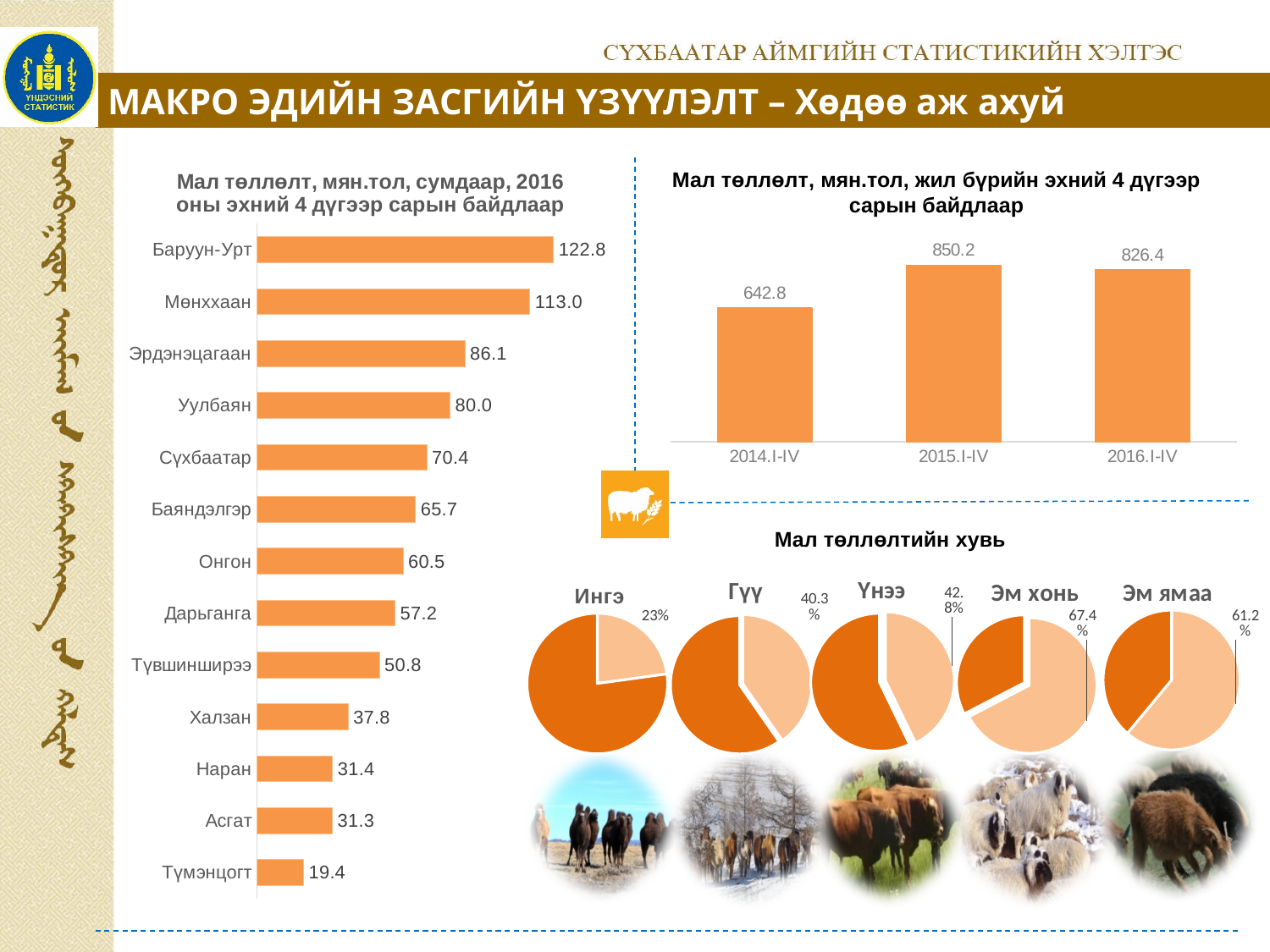
In the left chart (Мал төллөлт by soum, 2016), how many soums are shown? 13 In the top-right chart (Мал төллөлт by year, first 4 months), what is the difference between 2015.I-IV and 2014.I-IV? 207.4 In the pie charts (Мал төллөлтийн хувь), what share is shown for Эм хонь? 67.4% In the left chart (Мал төллөлт by soum, 2016), what is the difference between Баруун-Урт and Мөнххаан? 9.8 In the left chart (Мал төллөлт by soum, 2016), which soum has the lowest value? Түмэнцогт In the left chart (Мал төллөлт by soum, 2016), what is the value for Баруун-Урт? 122.8 How many pie charts are shown under the title Мал төллөлтийн хувь? 5 In the top-right chart (Мал төллөлт by year, first 4 months), which year has the highest value? 2015.I-IV What kind of chart is the left chart (Мал төллөлт by soum, 2016)? Bar chart In the left chart (Мал төллөлт by soum, 2016), what is the value for Онгон? 60.5 In the top-right chart (Мал төллөлт by year, first 4 months), what is the value for 2015.I-IV? 850.2 In the top-right chart (Мал төллөлт by year, first 4 months), is the value for 2016.I-IV larger or smaller than the value for 2015.I-IV? Smaller